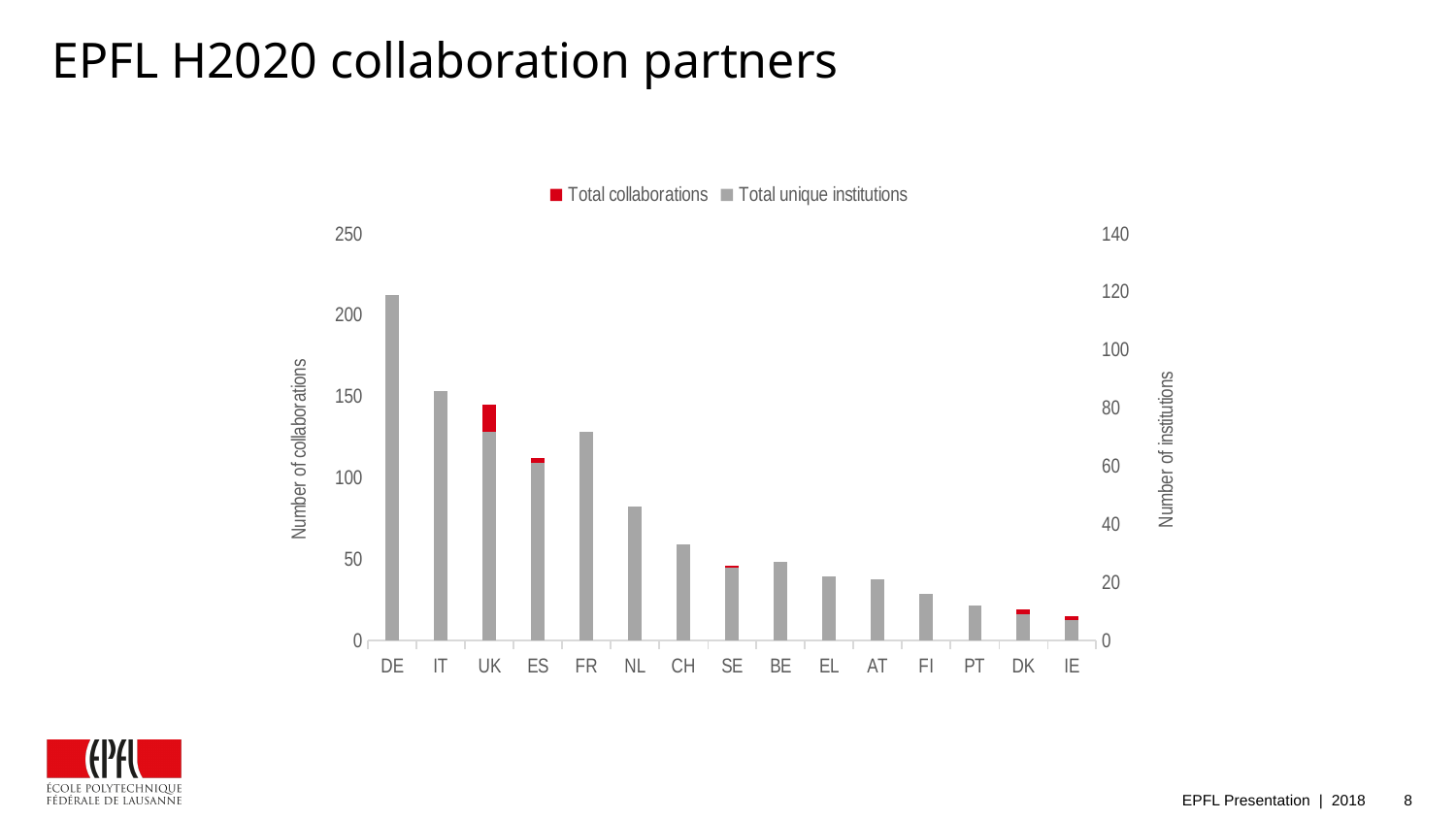
Which country has the shortest 'Total unique institutions' bar? IE Which country is listed first on the x axis? DE Which series is shown in red in the legend? Total collaborations How many countries are shown on the x axis? 15 How many series does the legend list? 2 Which country has the tallest 'Total unique institutions' bar? DE Which country has a taller 'Total unique institutions' bar, DE or IT? DE What type of chart is shown on the slide? Bar chart Which country has a taller 'Total unique institutions' bar, FR or NL? FR Do the 'Total unique institutions' bars generally rise or fall from left to right along the x axis? Fall Which country is listed last on the x axis? IE What is the title of the right-hand vertical axis? Number of institutions